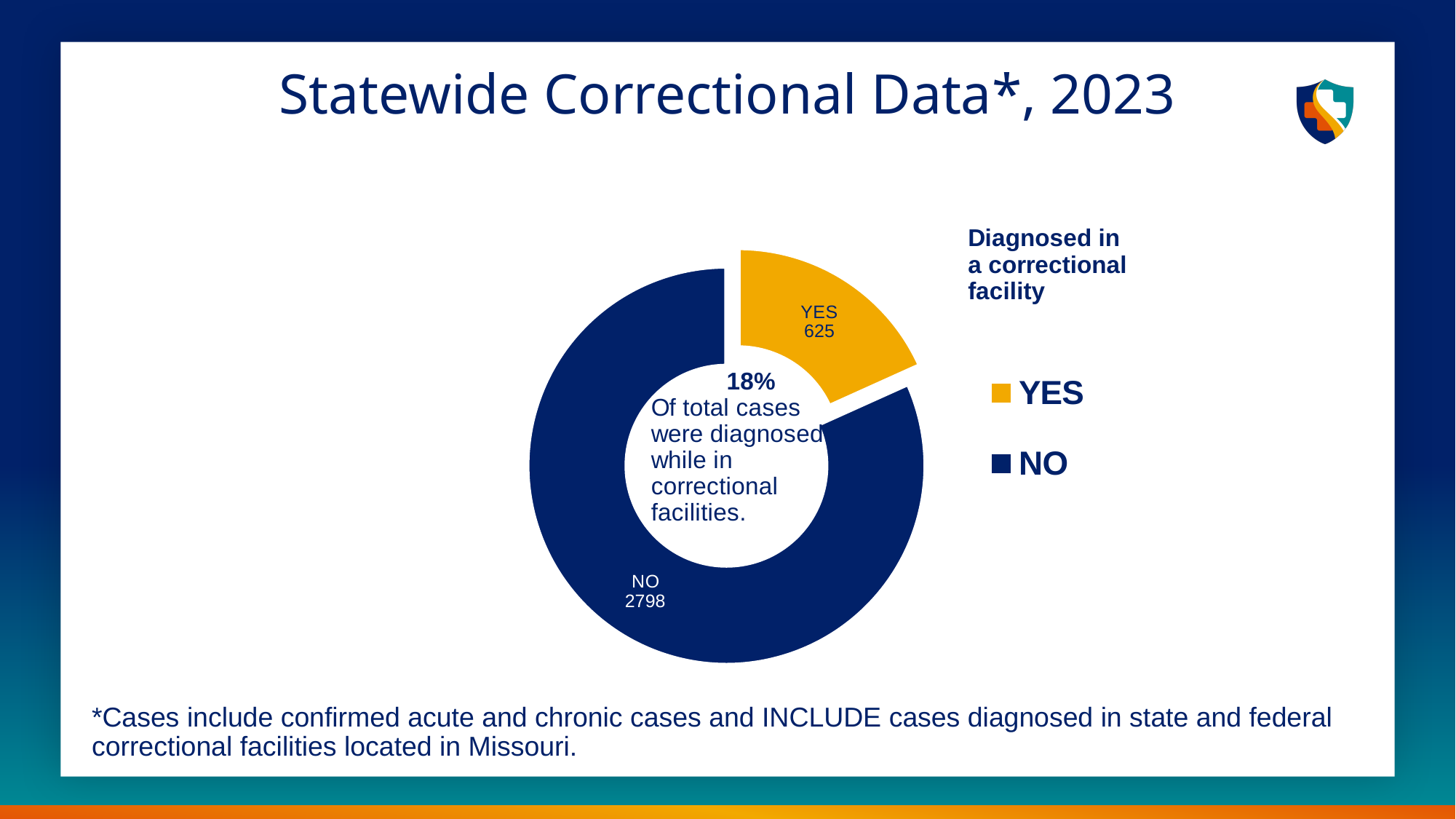
Which category has the smallest slice in the pie chart? YES What colour is the YES slice in the pie chart? Yellow How many categories does the pie chart show? 2 What is the difference between the NO and YES values? 2173 What kind of chart is shown on the slide? Doughnut chart What is the value for NO in the pie chart? 2798 What is the value for YES in the pie chart? 625 What is the title of the legend on the chart? Diagnosed in a correctional facility What is the total of the YES and NO values? 3423 Which category has the largest slice in the pie chart? NO What share of total cases were diagnosed while in correctional facilities, as printed on the chart? 18% Which is larger, the value for YES or the value for NO? NO